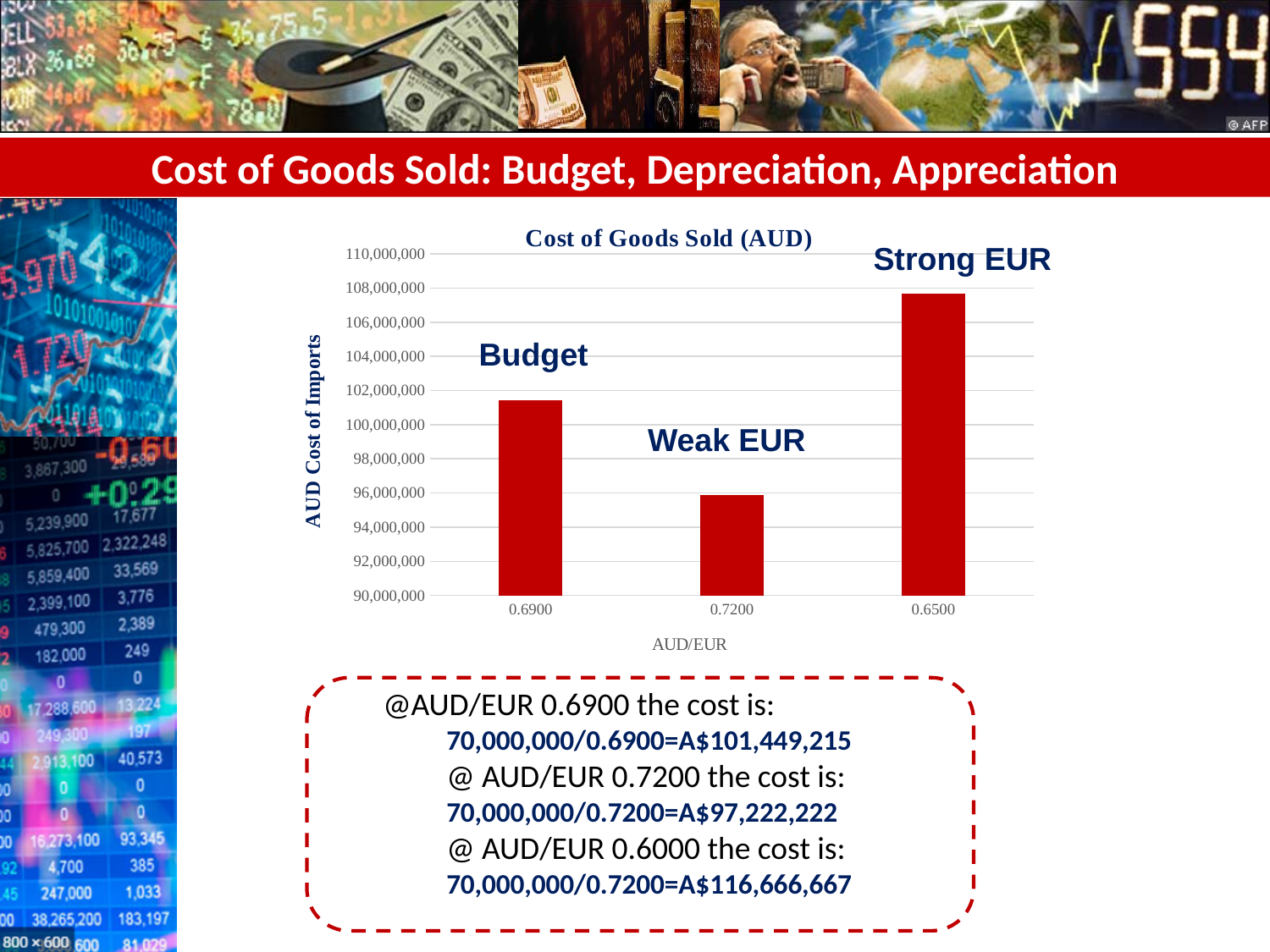
What is the title of the vertical axis in the chart? AUD Cost of Imports How many bars are plotted in the Cost of Goods Sold (AUD) chart? 3 What type of chart is shown on the slide? Bar chart Which is larger: the cost of goods sold at AUD/EUR 0.6900 or at AUD/EUR 0.7200? 0.6900 Which AUD/EUR rate has the lowest cost of goods sold in the chart? 0.7200 Is the cost of goods sold at AUD/EUR 0.6900 greater or less than 100,000,000? greater Is the cost of goods sold at AUD/EUR 0.6500 greater or less than 106,000,000? greater Which is larger: the cost of goods sold at AUD/EUR 0.6500 or at AUD/EUR 0.6900? 0.6500 Is the cost of goods sold at AUD/EUR 0.6900 greater or less than 102,000,000? less What label is placed above the bar for AUD/EUR 0.6500 in the chart? Strong EUR Which AUD/EUR rate has the highest cost of goods sold in the chart? 0.6500